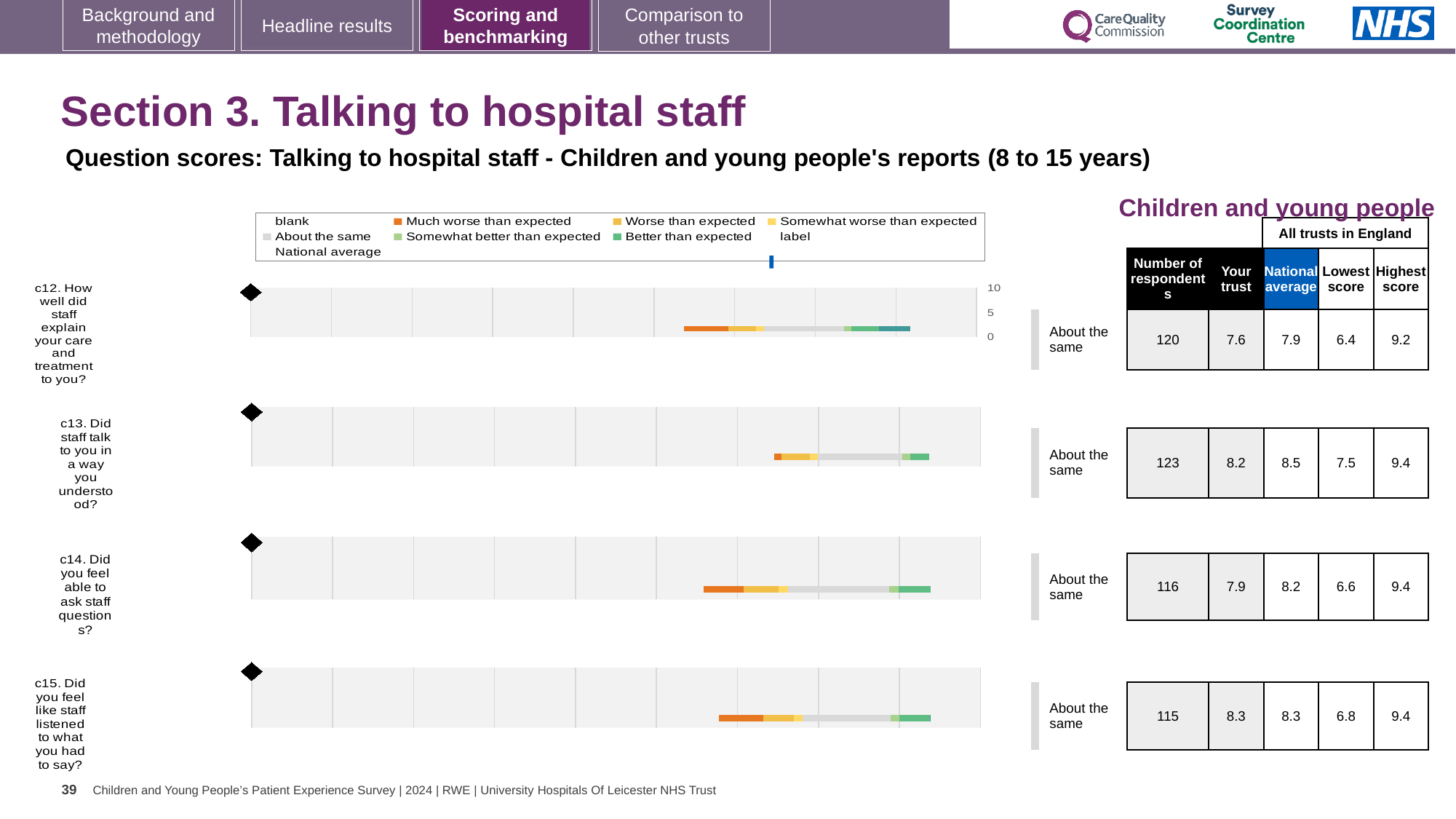
For c14, which is larger: the 'Your trust' score or the national average? National average How many question charts are shown on the slide? 4 Which question has the highest 'Your trust' score? c15 In the chart legend, which colour represents 'Much worse than expected'? orange Which question has the most respondents? c13 For c15 (Did you feel like staff listened to what you had to say?), what is the highest score among all trusts in England? 9.4 For c14 (Did you feel able to ask staff questions?), how many respondents are there? 116 For c12 (How well did staff explain your care and treatment to you?), what is the 'Your trust' score? 7.6 What type of chart is used for each question (c12 to c15)? bar chart For c13 (Did staff talk to you in a way you understood?), what is the national average score? 8.5 For c13, what is the difference between the national average and the 'Your trust' score? 0.3 Which question has the lowest 'Your trust' score? c12